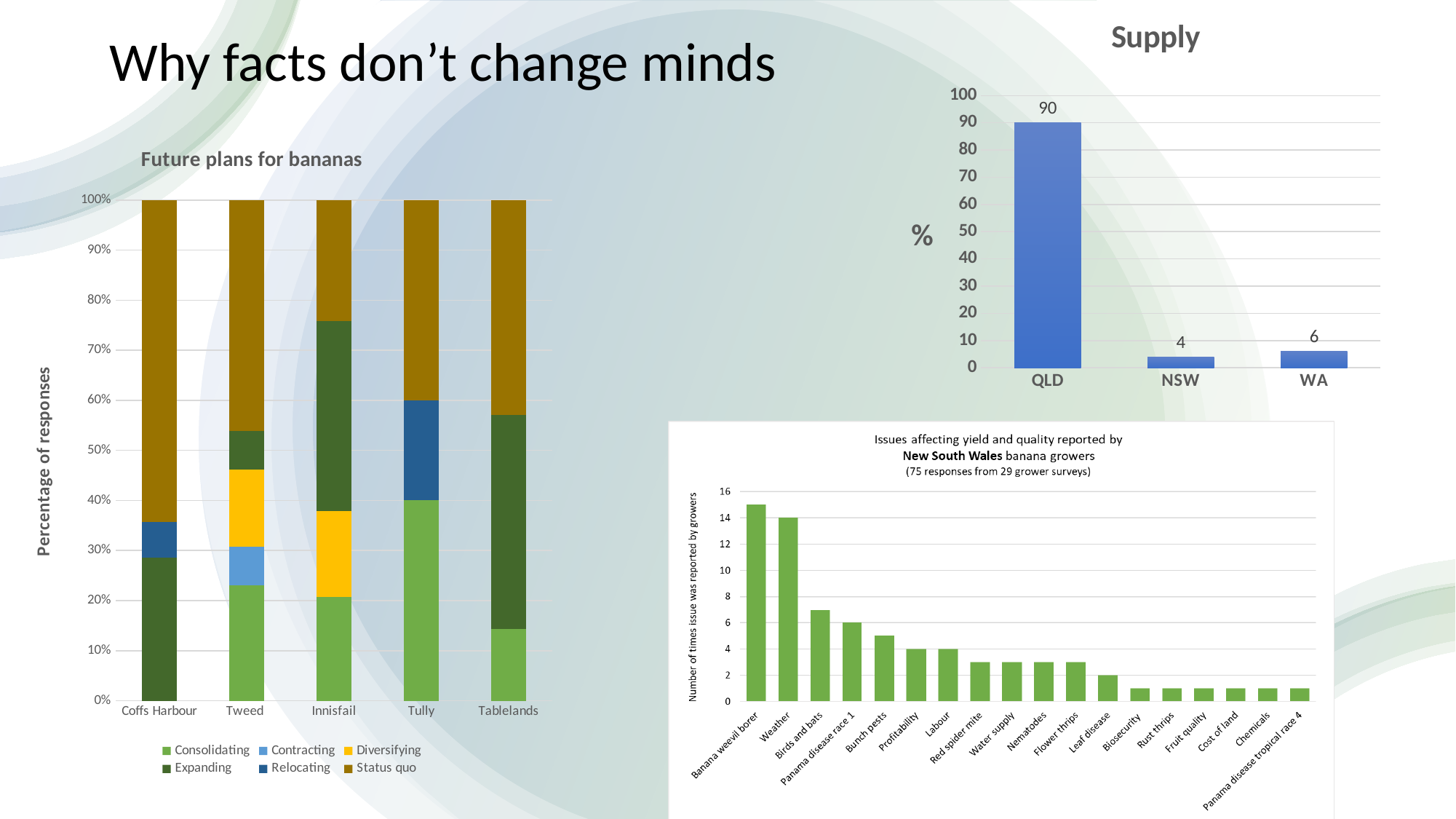
In the Supply chart, how many states are shown on the x axis? 3 In the Future plans for bananas chart, how many series does the legend list? 6 In the Future plans for bananas chart, is the Status quo segment for Coffs Harbour greater or less than 50% of responses? greater In the Supply chart, what is the value for NSW? 4 In the Supply chart, what is the value for QLD? 90 In the Future plans for bananas chart, how many regions are shown on the x axis? 5 In the Supply chart, which state has the lowest value? NSW In the Issues affecting yield and quality chart, is the value for Birds and bats greater or less than 6? greater In the Issues affecting yield and quality chart, how many times was Weather reported by growers? 14 In the Issues affecting yield and quality chart, which issue was reported the most times? Banana weevil borer In the Supply chart, what is the difference between the values for QLD and WA? 84 What kind of chart is the Future plans for bananas chart? stacked bar chart